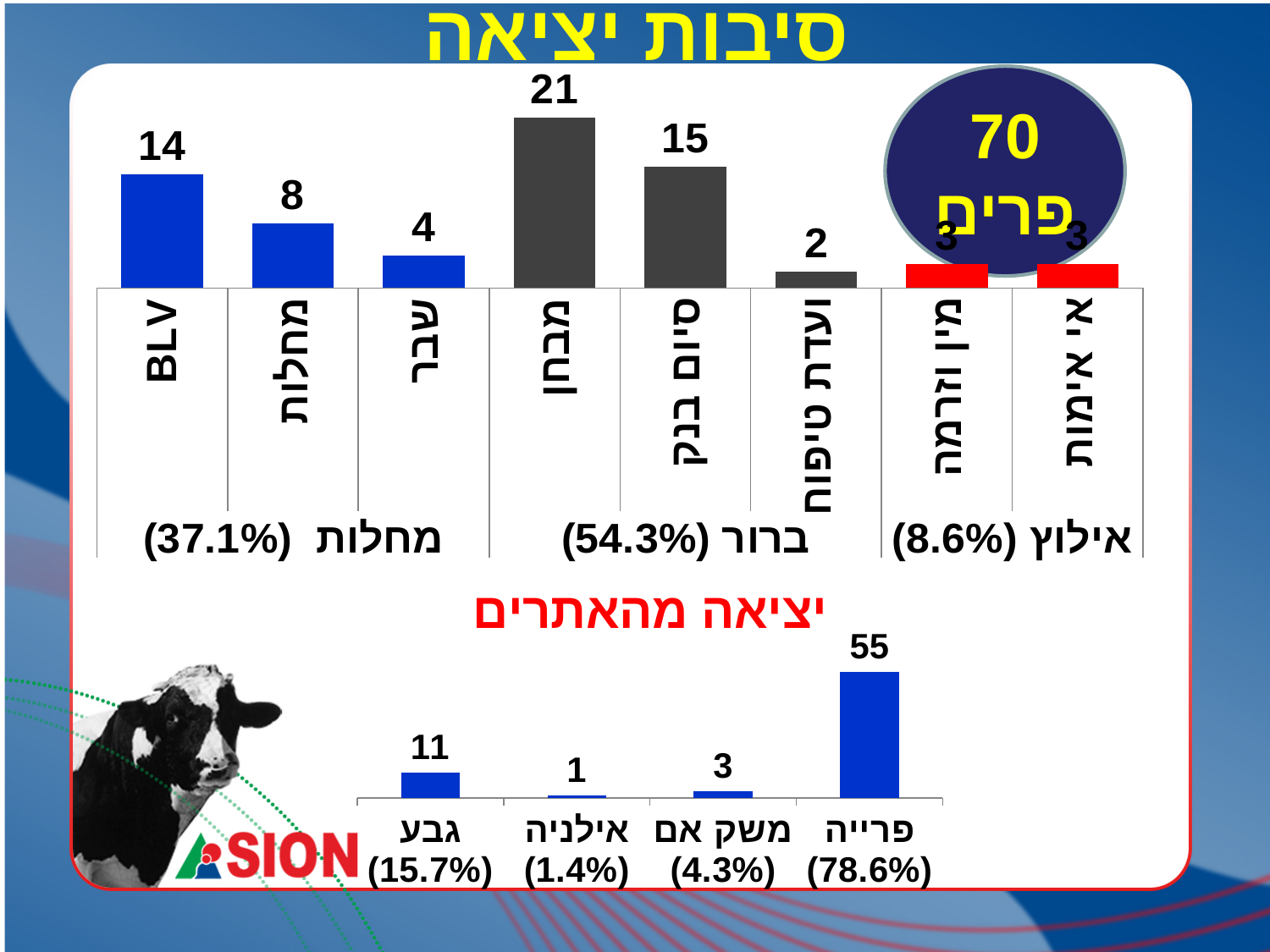
In the top chart 'סיבות יציאה', which category has the lowest value? ועדת טיפוח In the top chart 'סיבות יציאה', what percentage is shown for the group ברור? 54.3% In the top chart 'סיבות יציאה', what is the difference between the values for מבחן and סיום בנק? 6 What kind of chart is the bottom chart 'יציאה מהאתרים'? bar chart In the bottom chart 'יציאה מהאתרים', what is the value for פרייה? 55 In the bottom chart 'יציאה מהאתרים', which category has the lowest value? אילניה In the bottom chart 'יציאה מהאתרים', what is the difference between the values for פרייה and גבע? 44 In the top chart 'סיבות יציאה', how many categories are plotted? 8 In the top chart 'סיבות יציאה', which category has the highest value? מבחן In the top chart 'סיבות יציאה', what is the value for BLV? 14 In the top chart 'סיבות יציאה', what is the value for מבחן? 21